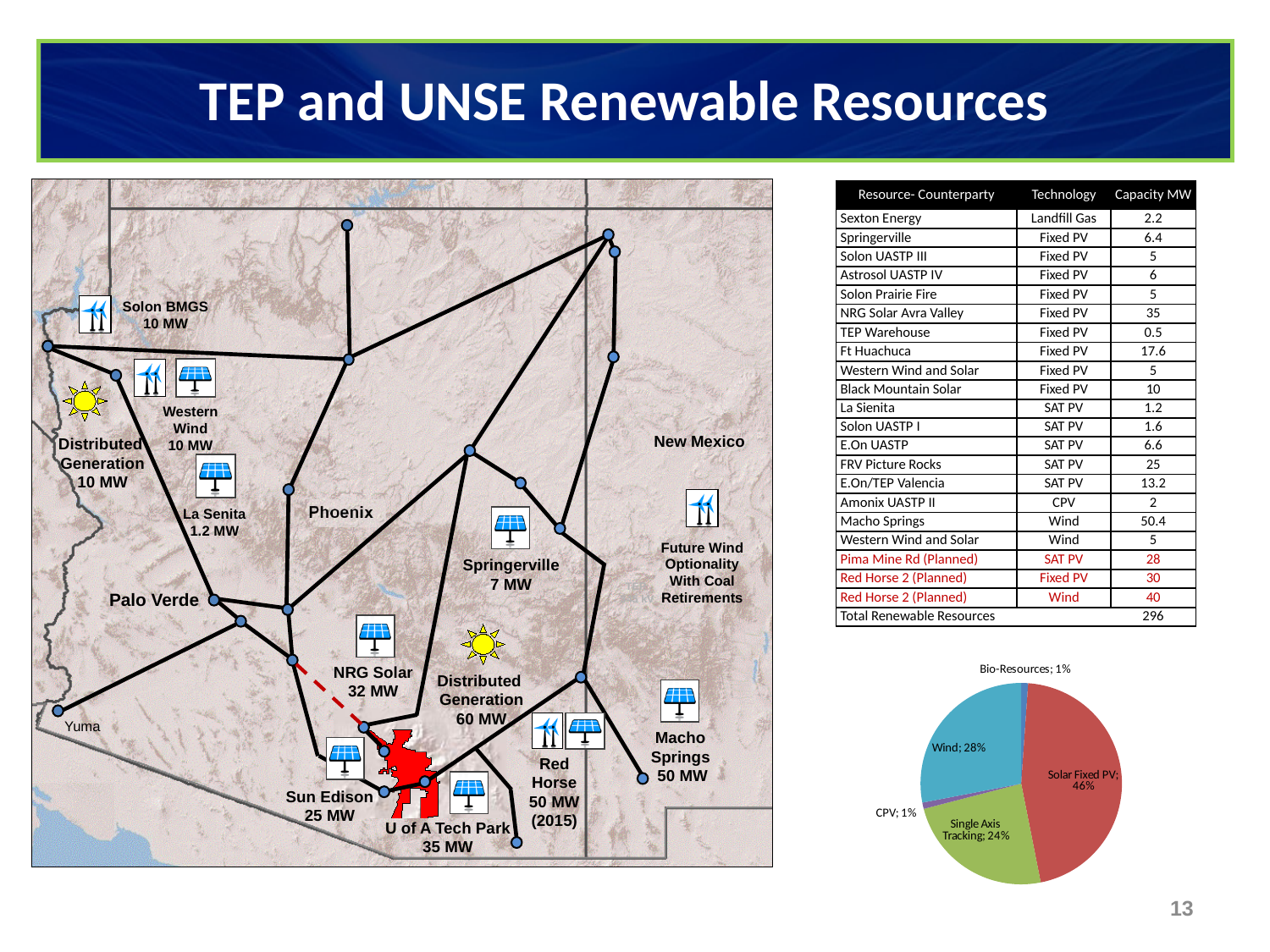
In the pie chart, how many percentage points larger is Wind than Single Axis Tracking? 4 In the pie chart, what share does CPV have? 1% In the pie chart, how many percentage points larger is Solar Fixed PV than Wind? 18 Which slice of the pie chart is the largest? Solar Fixed PV In the pie chart, what share does Solar Fixed PV have? 46% What colour is the Solar Fixed PV slice in the pie chart? red How many slices does the pie chart have? 5 In the pie chart, what share does Wind have? 28% What kind of chart is shown in the lower right of the slide? pie chart In the pie chart, which is larger: Wind or Single Axis Tracking? Wind